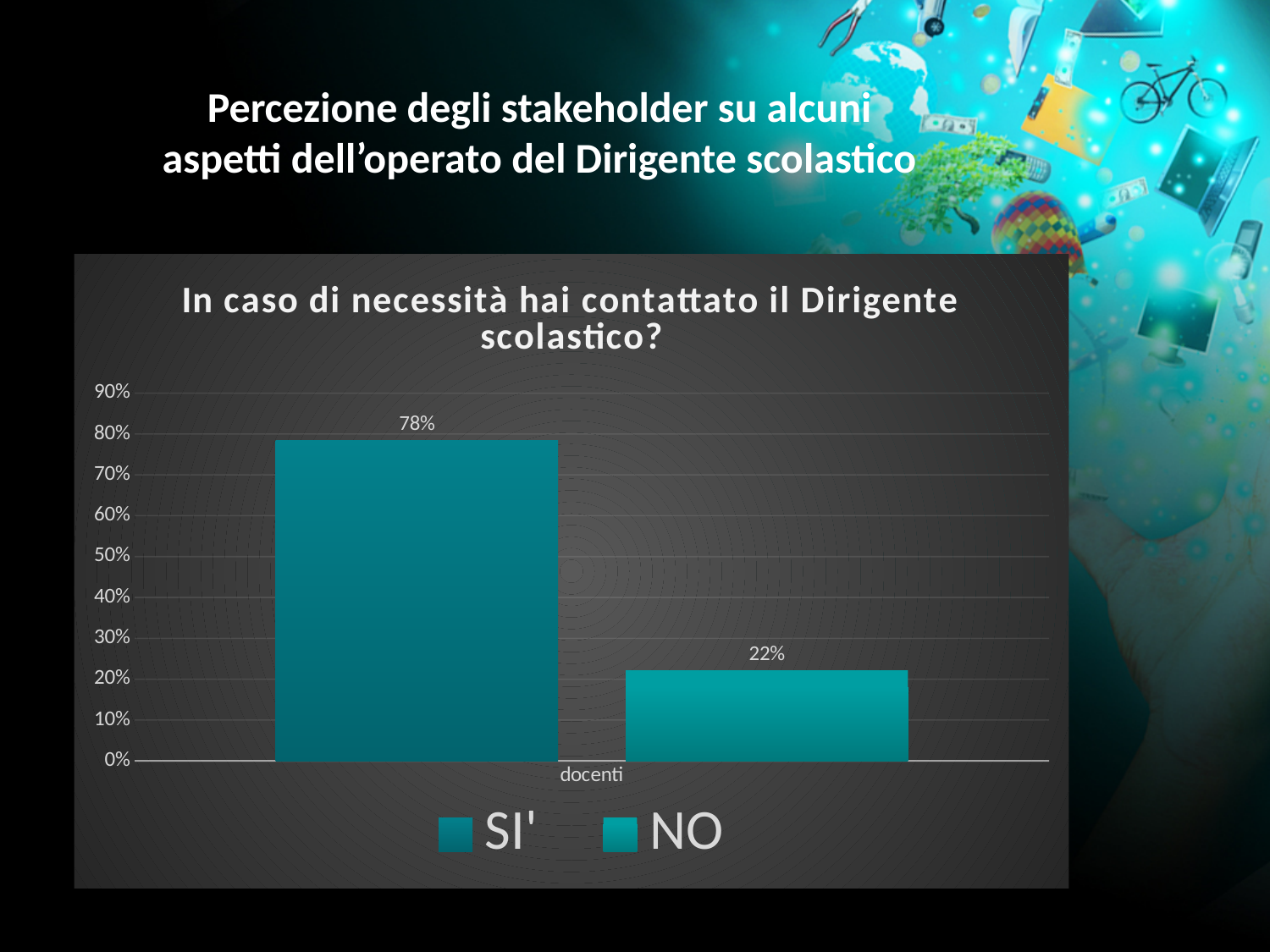
Which series has the highest value? SI' What is the value for SI' in the chart? 78% What is the title of the chart? In caso di necessità hai contattato il Dirigente scolastico? Which series has the lowest value? NO Which is larger, the value for SI' or the value for NO? SI' What is the value for NO in the chart? 22% What kind of chart is shown on the slide? bar chart How many series does the legend list? 2 Is the value for SI' greater or less than 70%? greater What is the category label on the x axis? docenti What is the difference between the SI' and NO values? 56% Is the value for NO greater or less than 30%? less